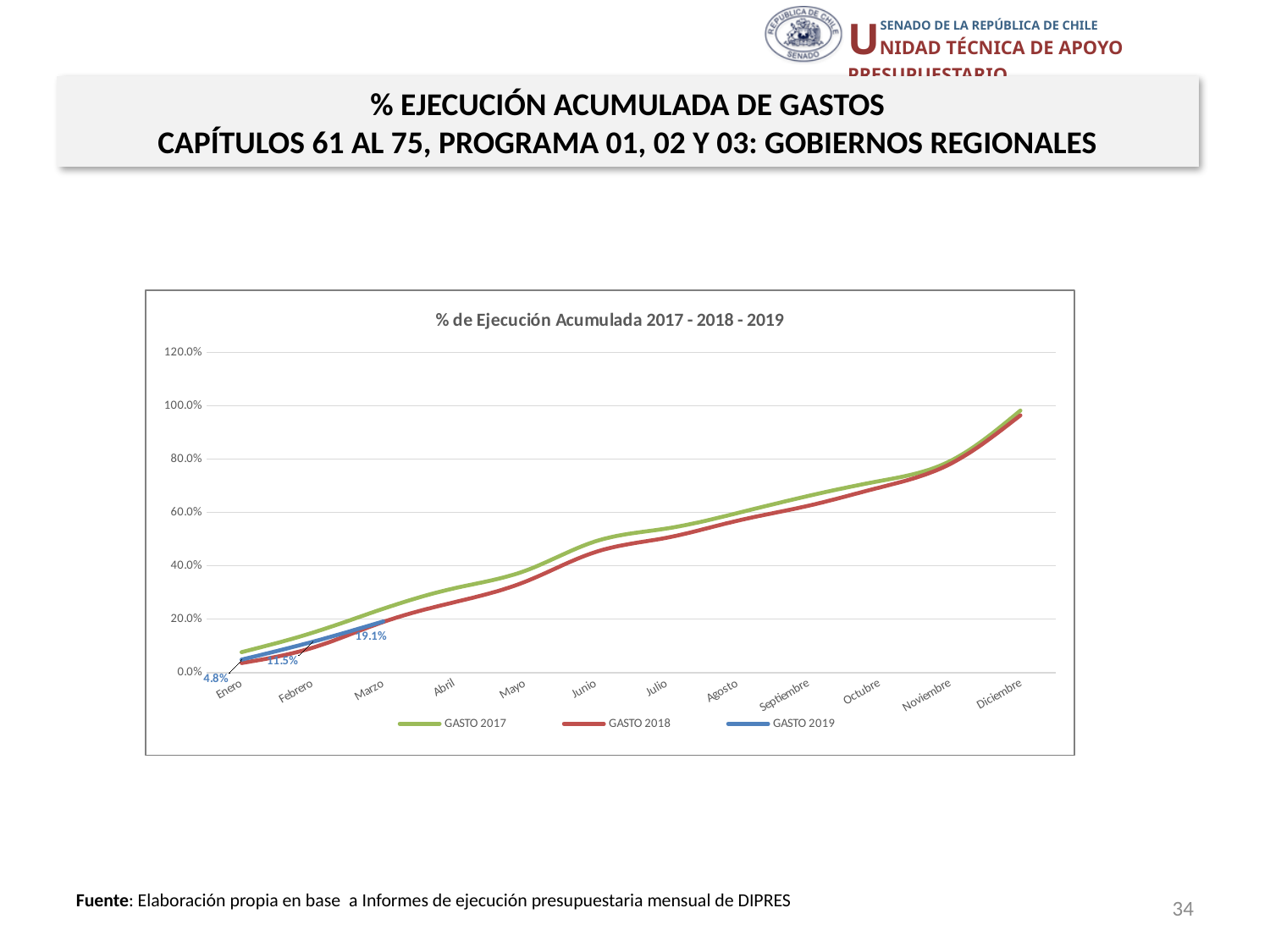
What is the difference between the GASTO 2019 values for Febrero and Enero? 6.7% Do the GASTO 2017 values rise or fall from Enero to Diciembre? Rise What is the value for GASTO 2019 in Enero? 4.8% What is the difference between the GASTO 2019 values for Marzo and Febrero? 7.6% What is the value for GASTO 2019 in Febrero? 11.5% Which month has the highest labelled value for GASTO 2019? Marzo What kind of chart is shown on the slide? Line chart How many months are shown on the x axis? 12 What is the value for GASTO 2019 in Marzo? 19.1% What is the title of the chart? % de Ejecución Acumulada 2017 - 2018 - 2019 Is the value for GASTO 2018 in Diciembre greater or less than 80.0%? greater How many series does the legend list? 3